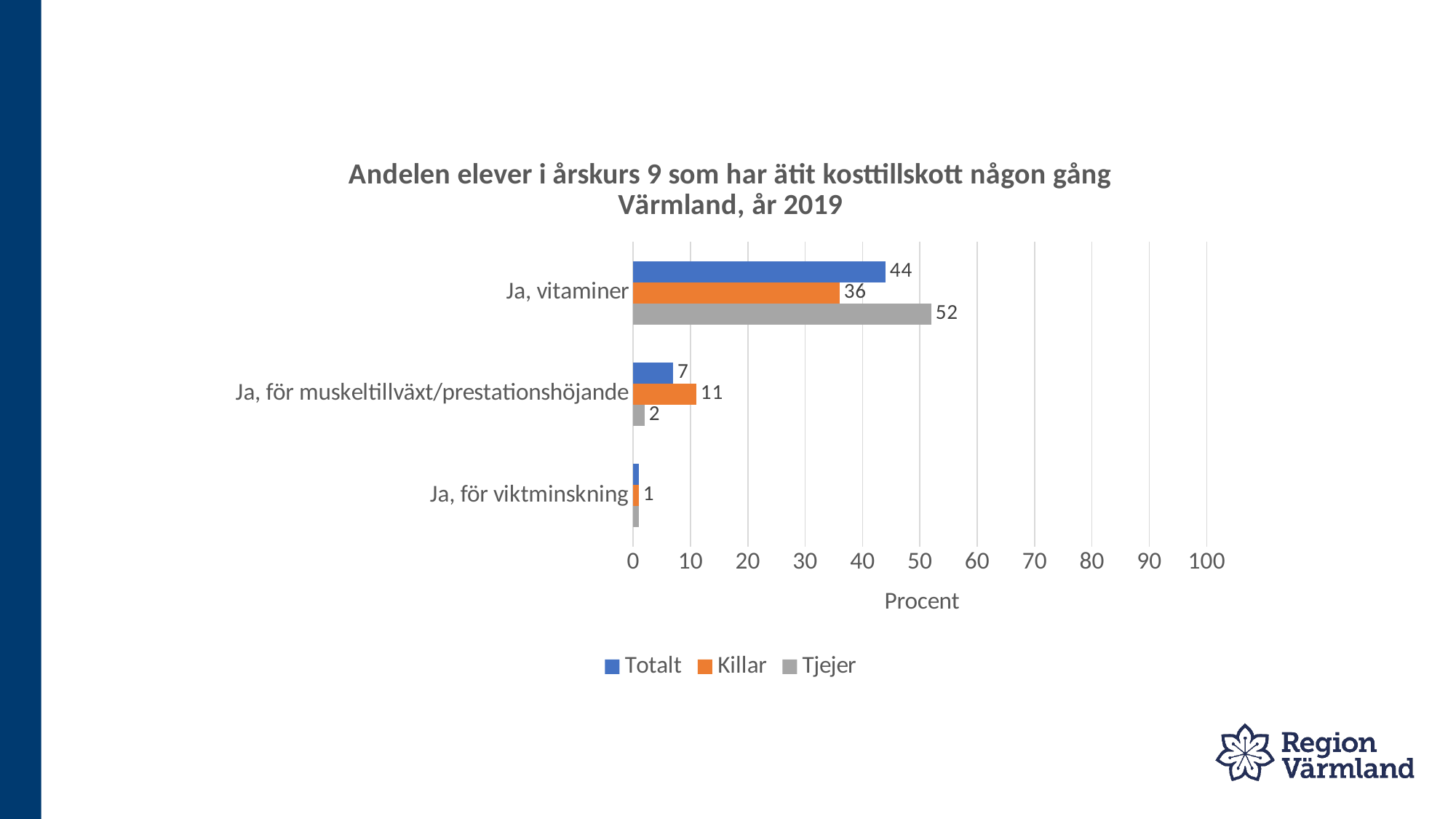
What is the value for Totalt in the category "Ja, för muskeltillväxt/prestationshöjande"? 7 How many series does the legend list? 3 Which series has the highest value in the category "Ja, vitaminer"? Tjejer What is the value for Killar in the category "Ja, vitaminer"? 36 What kind of chart is shown on the slide? Bar chart How many categories are shown on the chart? 3 What is the value for Killar in the category "Ja, för viktminskning"? 1 What is the difference between the Tjejer and Killar values in the category "Ja, vitaminer"? 16 In the category "Ja, för muskeltillväxt/prestationshöjande", which is larger: the value for Killar or the value for Totalt? Killar Is the Totalt value for "Ja, vitaminer" greater or less than 40? greater What is the value for Tjejer in the category "Ja, vitaminer"? 52 Which series has the lowest value in the category "Ja, för muskeltillväxt/prestationshöjande"? Tjejer